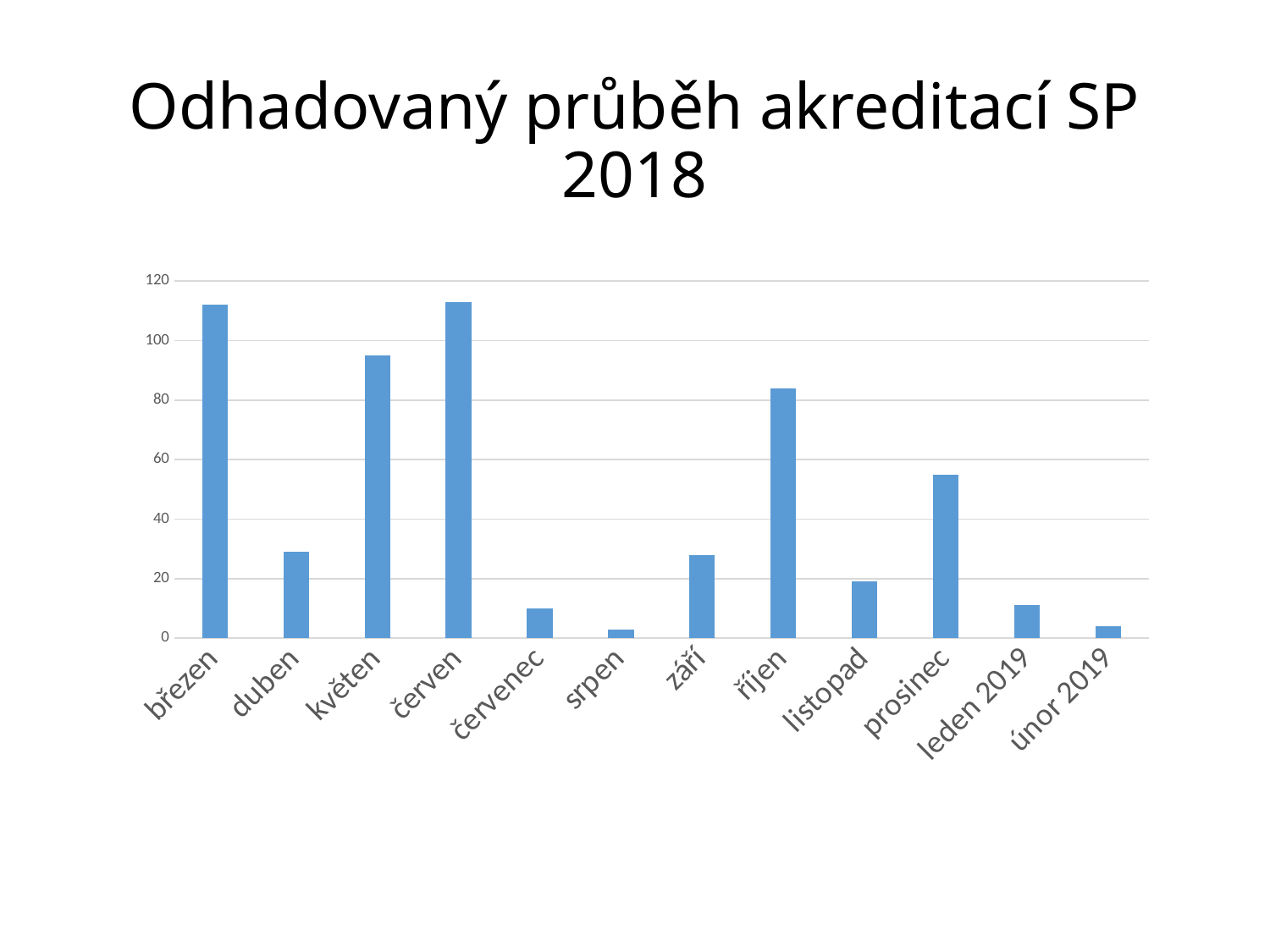
Is the value for květen greater or less than 80? greater Is the value for říjen greater or less than 100? less Which is larger, the value for květen or the value for prosinec? květen How many categories (months) are shown on the x axis? 12 Is the value for březen greater or less than 100? greater What kind of chart is shown on the slide? bar chart What is the highest value shown on the y axis? 120 What is the title of the chart? Odhadovaný průběh akreditací SP 2018 Which is larger, the value for listopad or the value for září? září